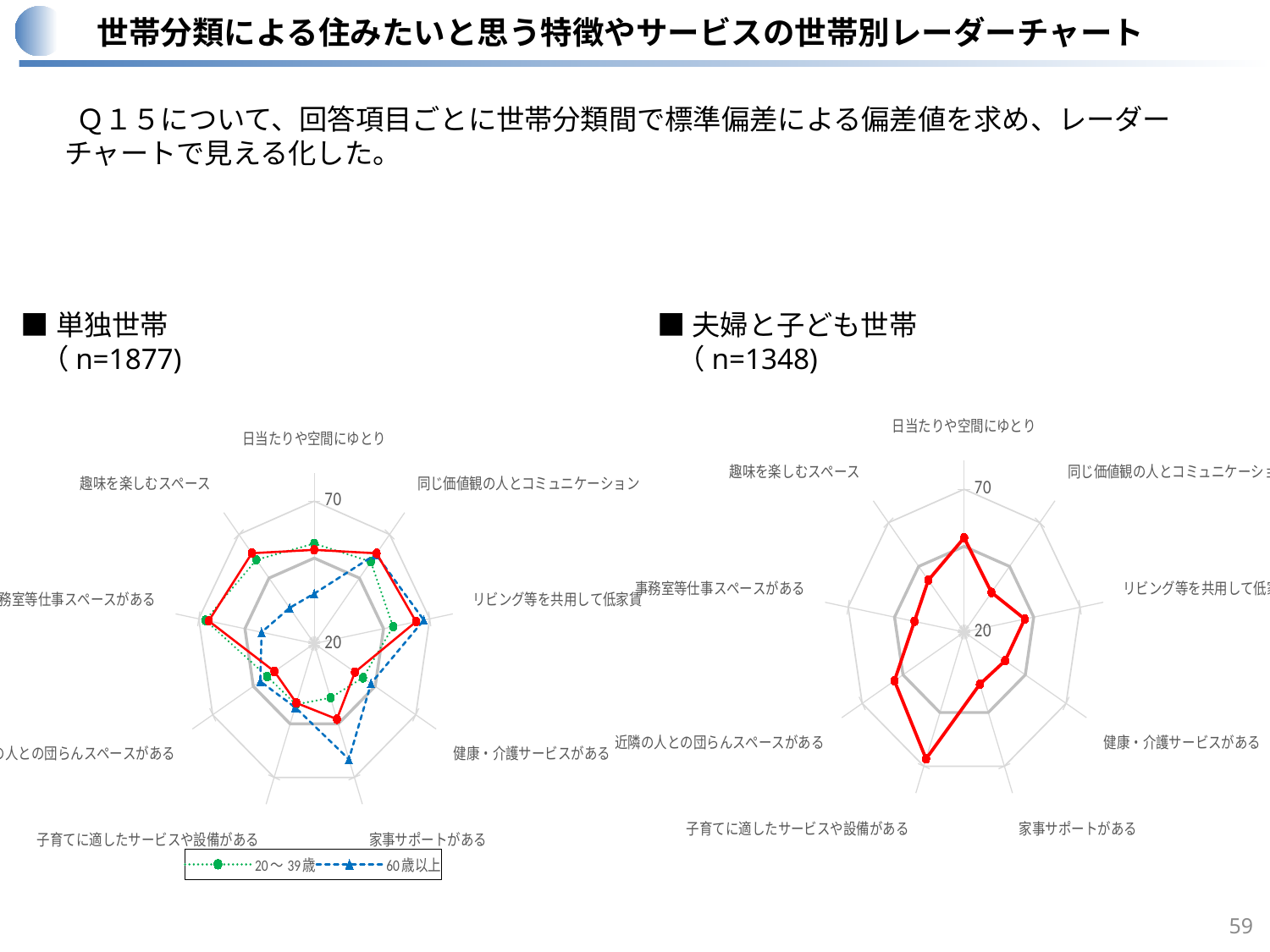
How many categories (axes) does the 単独世帯 radar chart have? 9 How many series does the legend under the 単独世帯 chart list? 2 In the 夫婦と子ども世帯 chart, is the value for 子育てに適したサービスや設備がある greater or less than 20? greater In the 夫婦と子ども世帯 chart, which category has the highest value? 子育てに適したサービスや設備がある What is the sample size (n) shown for the 夫婦と子ども世帯 chart? n=1348 In the 単独世帯 chart, which category has the highest value for the 20〜39歳 series? 事務室等仕事スペースがある In the 単独世帯 chart, which category has the highest value for the 60歳以上 series? リビング等を共用して低家賃 What kind of chart is used on this slide? Radar chart In the 単独世帯 chart, which is larger for the 60歳以上 series: 家事サポートがある or 日当たりや空間にゆとり? 家事サポートがある In the 夫婦と子ども世帯 chart, which is larger: the value for 子育てに適したサービスや設備がある or for 同じ価値観の人とコミュニケーション? 子育てに適したサービスや設備がある In the 単独世帯 chart, is the value of the 60歳以上 series for 日当たりや空間にゆとり greater or less than 70? less In the 単独世帯 chart, which series is drawn with the blue dashed line and triangle markers? 60歳以上